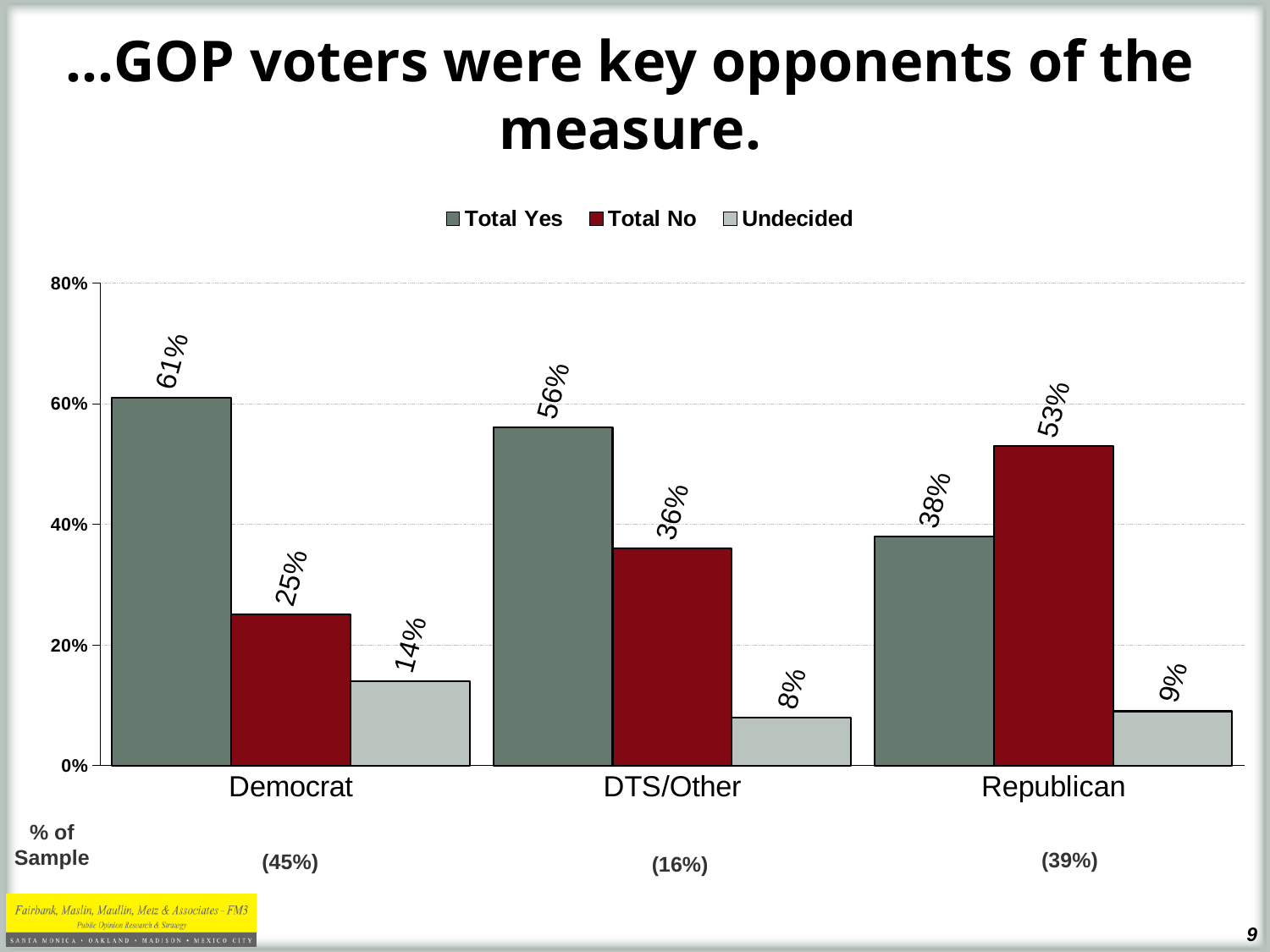
What percentage of the sample is Republican, as shown below the chart? 39% What is the Total No value for Republican? 53% Which is larger for DTS/Other, Total Yes or Total No? Total Yes What is the difference between Total Yes and Total No for Republican? 15% How many series does the legend list? 3 Which category has the lowest Total No value? Democrat How many categories are shown on the x axis? 3 What kind of chart is shown on the slide? bar chart What is the Total Yes value for Democrat? 61% Is the Total No value for DTS/Other greater or less than 40%? less What is the Undecided value for DTS/Other? 8% Which category has the highest Total Yes value? Democrat